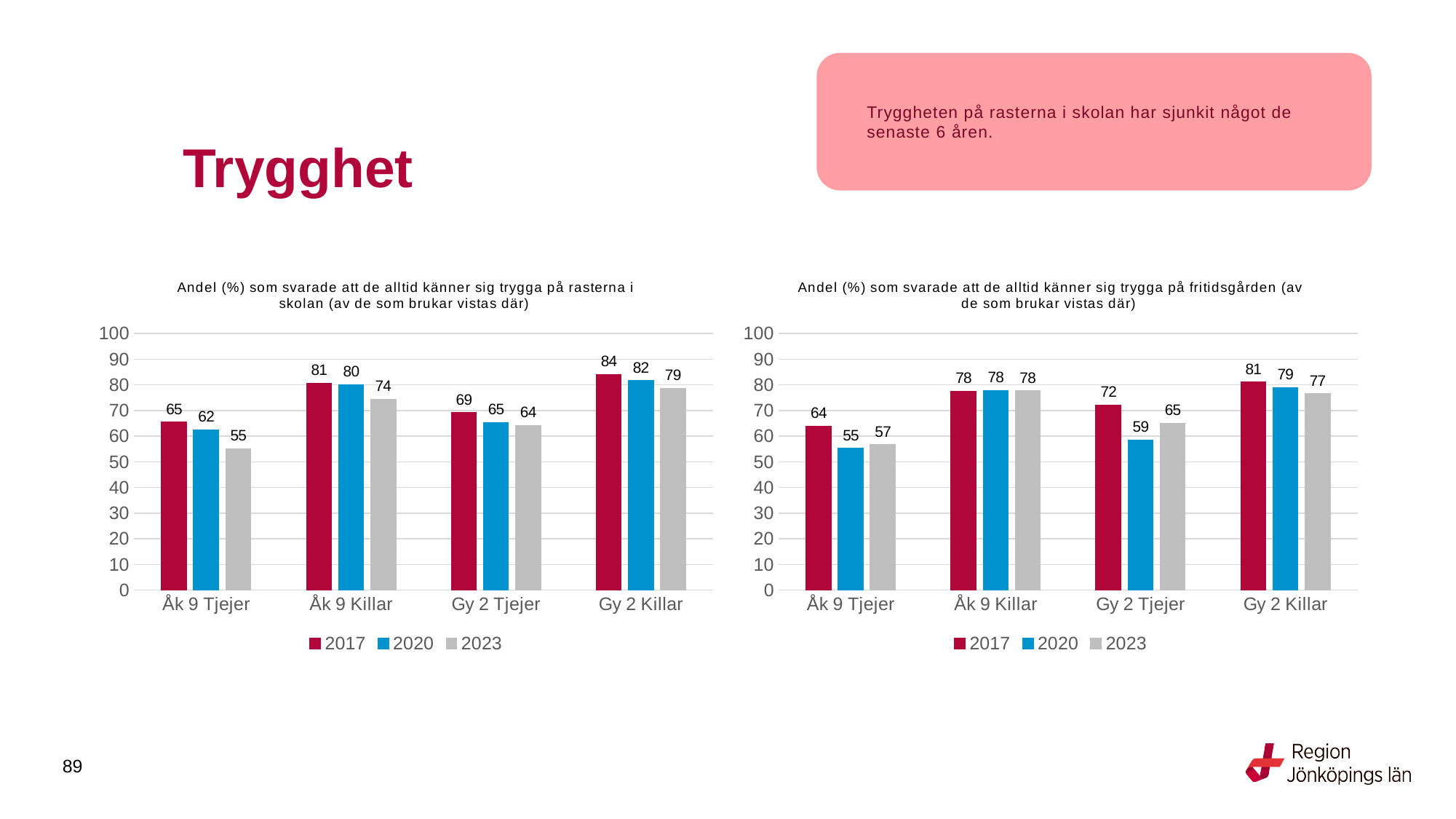
In the right chart (trygga på fritidsgården), is the 2023 value for Gy 2 Killar greater or less than 70? greater What kind of chart is the left chart (trygga på rasterna i skolan)? Bar chart In the right chart (trygga på fritidsgården), what is the difference between the 2017 and 2020 values for Åk 9 Tjejer? 9 In the left chart (trygga på rasterna i skolan), do the values for Gy 2 Killar rise or fall from 2017 to 2023? Fall In the left chart (trygga på rasterna i skolan), what is the difference between the 2017 and 2023 values for Åk 9 Tjejer? 10 In the right chart (trygga på fritidsgården), what is the value for Gy 2 Tjejer in 2020? 59 In the left chart (trygga på rasterna i skolan), what is the value for Åk 9 Tjejer in 2023? 55 How many series does the legend of the right chart (trygga på fritidsgården) list? 3 How many categories are shown on the x axis of the left chart (trygga på rasterna i skolan)? 4 In the left chart (trygga på rasterna i skolan), which category has the highest value for 2017? Gy 2 Killar In the left chart (trygga på rasterna i skolan), which is larger: the 2023 value for Åk 9 Killar or the 2023 value for Gy 2 Tjejer? Åk 9 Killar In the right chart (trygga på fritidsgården), which category has the lowest value for 2020? Åk 9 Tjejer